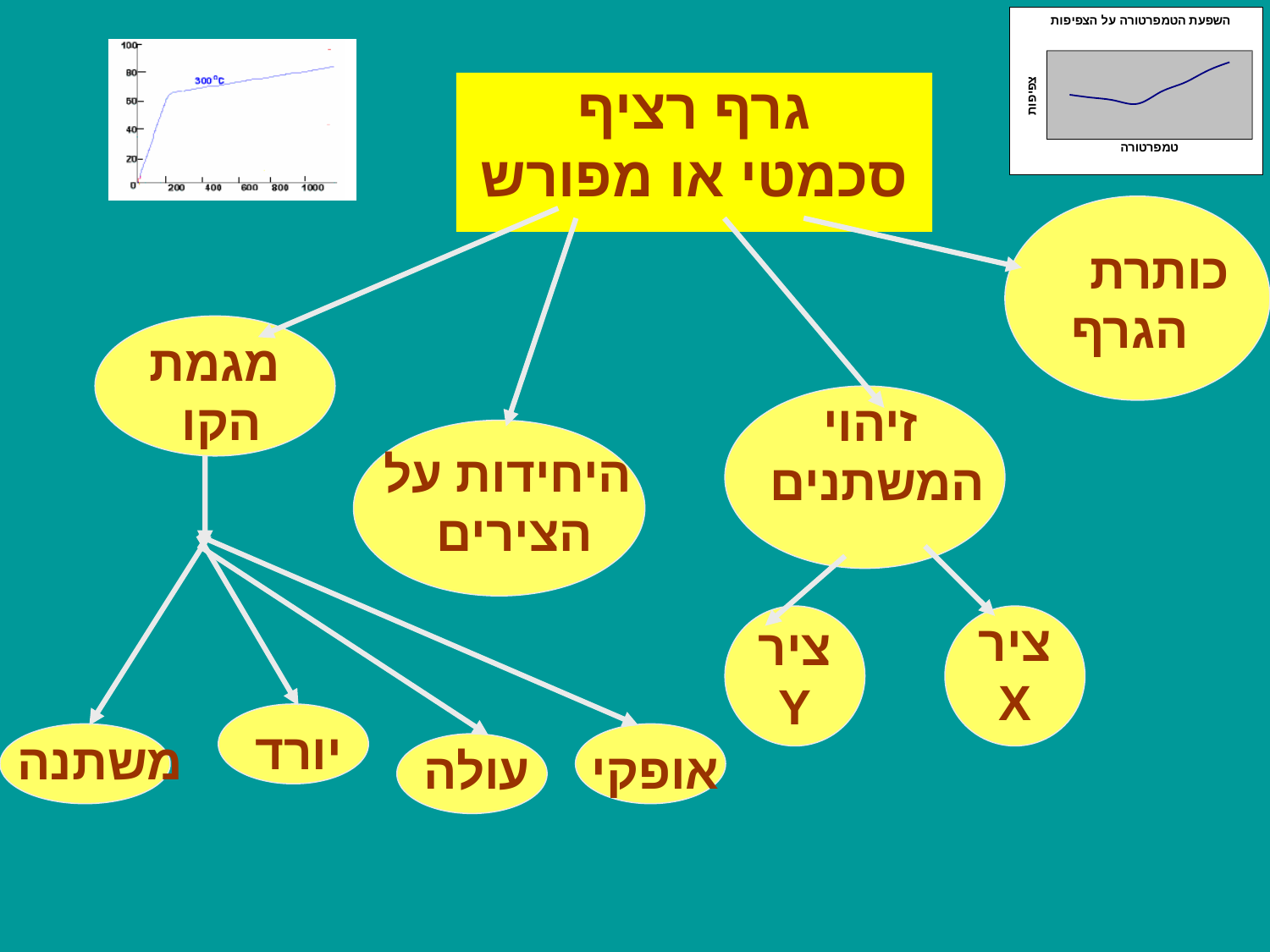
In the top-right chart, what is the label on the x axis? טמפרטורה In the top-right chart, does the line rise or fall toward the right end of the x axis? rise In the top-left chart, is the value of the line at x = 1000 greater or less than 60? greater In the top-left chart, what is the highest tick value shown on the y axis? 100 In the top-left chart, is the value of the line at x = 400 greater or less than 80? less How many series does the top-left chart plot? 1 What kind of chart is the one in the top-right corner of the slide? line chart What is the title of the chart in the top-right corner of the slide? השפעת הטמפרטורה על הצפיפות In the top-right chart, does the line first fall or first rise as temperature increases from the left? fall In the top-left chart, does the line overall rise or fall as the x-axis values increase? rise In the top-left chart, is the value of the line at x = 200 greater or less than 40? greater What kind of chart is the one in the top-left corner of the slide? line chart